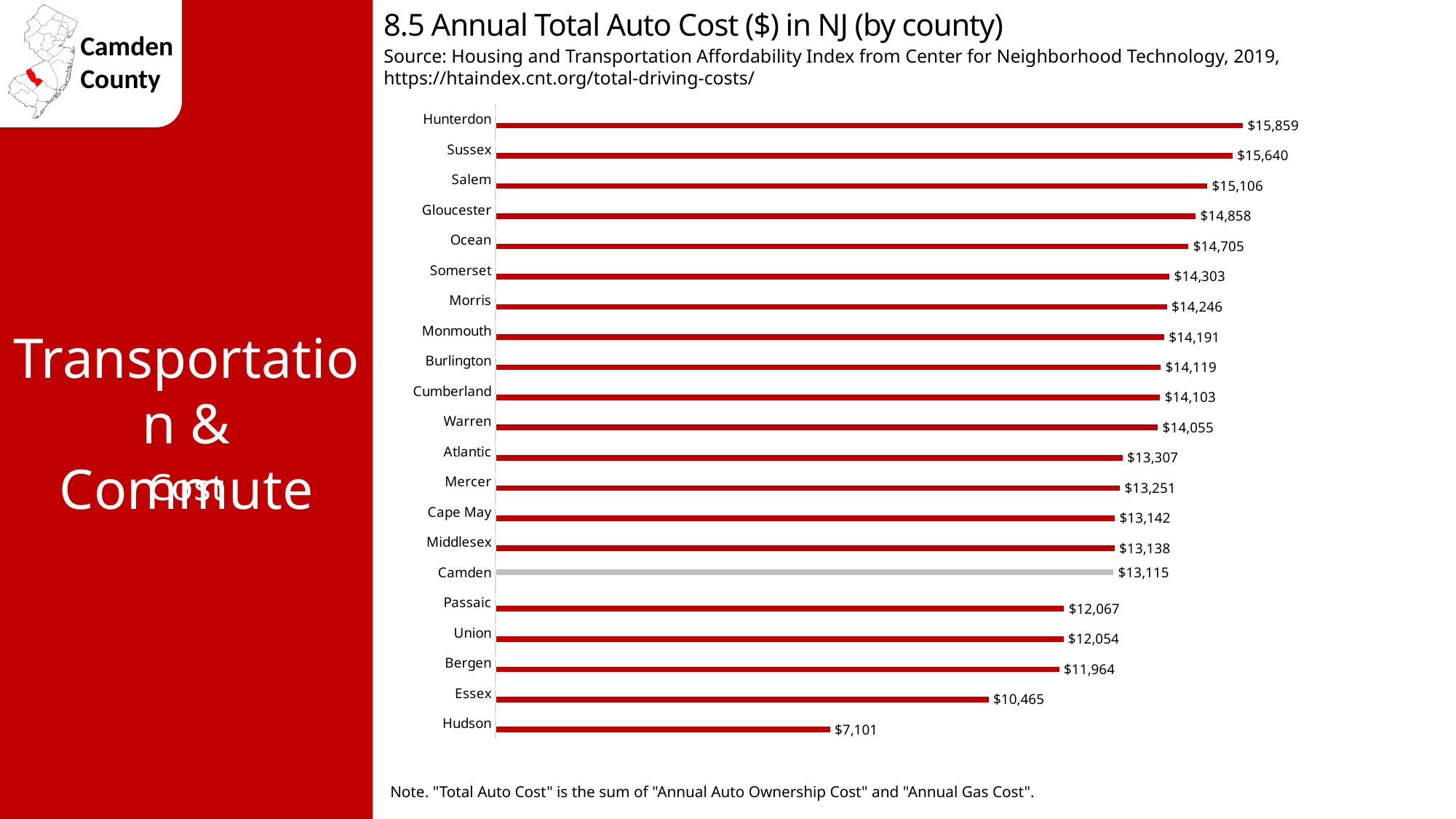
What is the difference in annual total auto cost between Hunterdon and Hudson counties? $8,758 What is the annual total auto cost for Essex County? $10,465 Which county has a higher annual total auto cost, Sussex or Salem? Sussex How much higher is Gloucester County's annual total auto cost than Camden County's? $1,743 Which county has the highest annual total auto cost? Hunterdon What is the annual total auto cost for Camden County? $13,115 What type of chart is used to show annual total auto cost by county? Bar chart Which county's bar is shown in gray rather than red? Camden What is the annual total auto cost for Gloucester County? $14,858 How many counties are shown in the chart? 21 Which county has the lowest annual total auto cost? Hudson Which county has a higher annual total auto cost, Bergen or Essex? Bergen